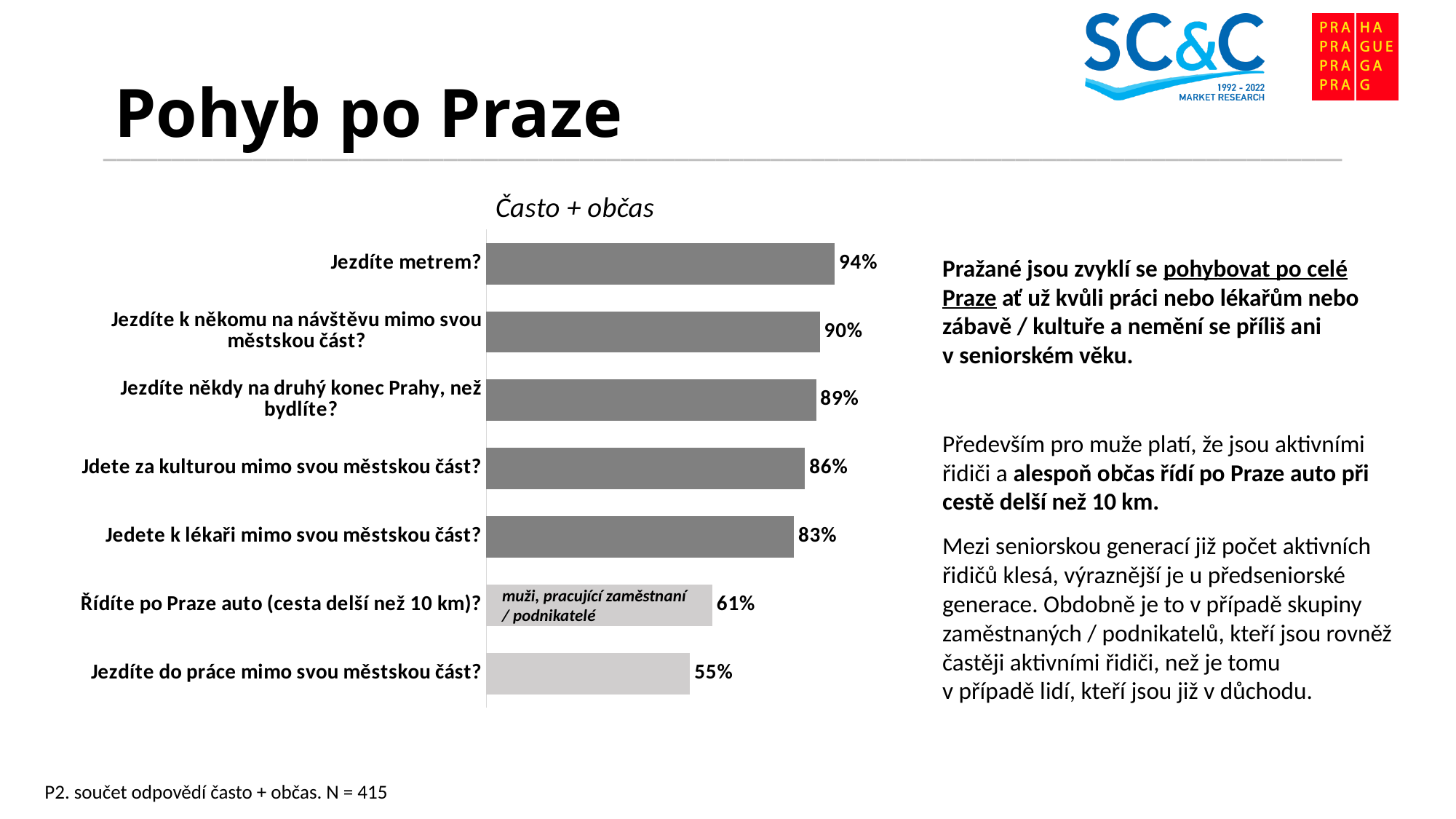
How many categories are shown in the chart? 7 Which category has the highest value? Jezdíte metrem? What is the title of the chart? Často + občas What kind of chart is shown on the slide? Bar chart What is the value for "Řídíte po Praze auto (cesta delší než 10 km)?"? 61% What is the difference between the values for "Jezdíte metrem?" and "Jezdíte do práce mimo svou městskou část?"? 39% What is the value for "Jezdíte do práce mimo svou městskou část?"? 55% Which category has the lowest value? Jezdíte do práce mimo svou městskou část? Which is larger: the value for "Jdete za kulturou mimo svou městskou část?" or for "Jedete k lékaři mimo svou městskou část?"? Jdete za kulturou mimo svou městskou část? What is the value for "Jedete k lékaři mimo svou městskou část?"? 83% What is the difference between the values for "Jezdíte k někomu na návštěvu mimo svou městskou část?" and "Jezdíte někdy na druhý konec Prahy, než bydlíte?"? 1% What is the value for "Jezdíte metrem?"? 94%